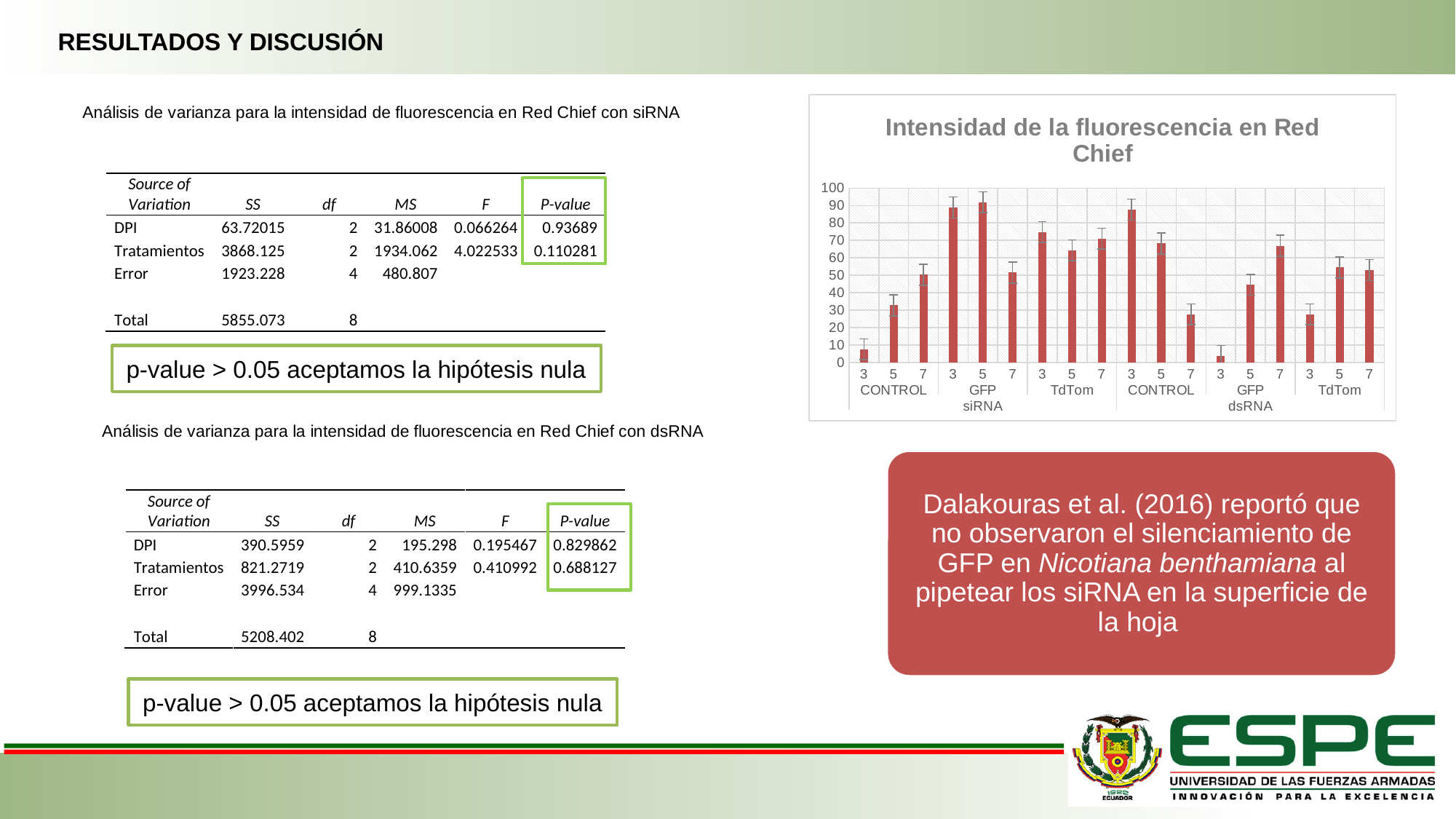
What kind of chart is shown on the slide? bar chart Is the value for CONTROL at 3 DPI in the siRNA group greater or less than 10? less Is the value for GFP at 5 DPI in the siRNA group greater or less than 80? greater How many bars are plotted in the chart? 18 Is the value for CONTROL at 3 DPI in the dsRNA group greater or less than 80? greater What is the title of the chart on the slide? Intensidad de la fluorescencia en Red Chief What is the maximum value shown on the vertical axis of the chart? 100 Do the CONTROL values in the siRNA group rise or fall from 3 DPI to 7 DPI? rise Which is larger in the dsRNA group: CONTROL at 3 DPI or CONTROL at 7 DPI? CONTROL at 3 DPI Which is larger in the siRNA group: GFP at 3 DPI or GFP at 7 DPI? GFP at 3 DPI